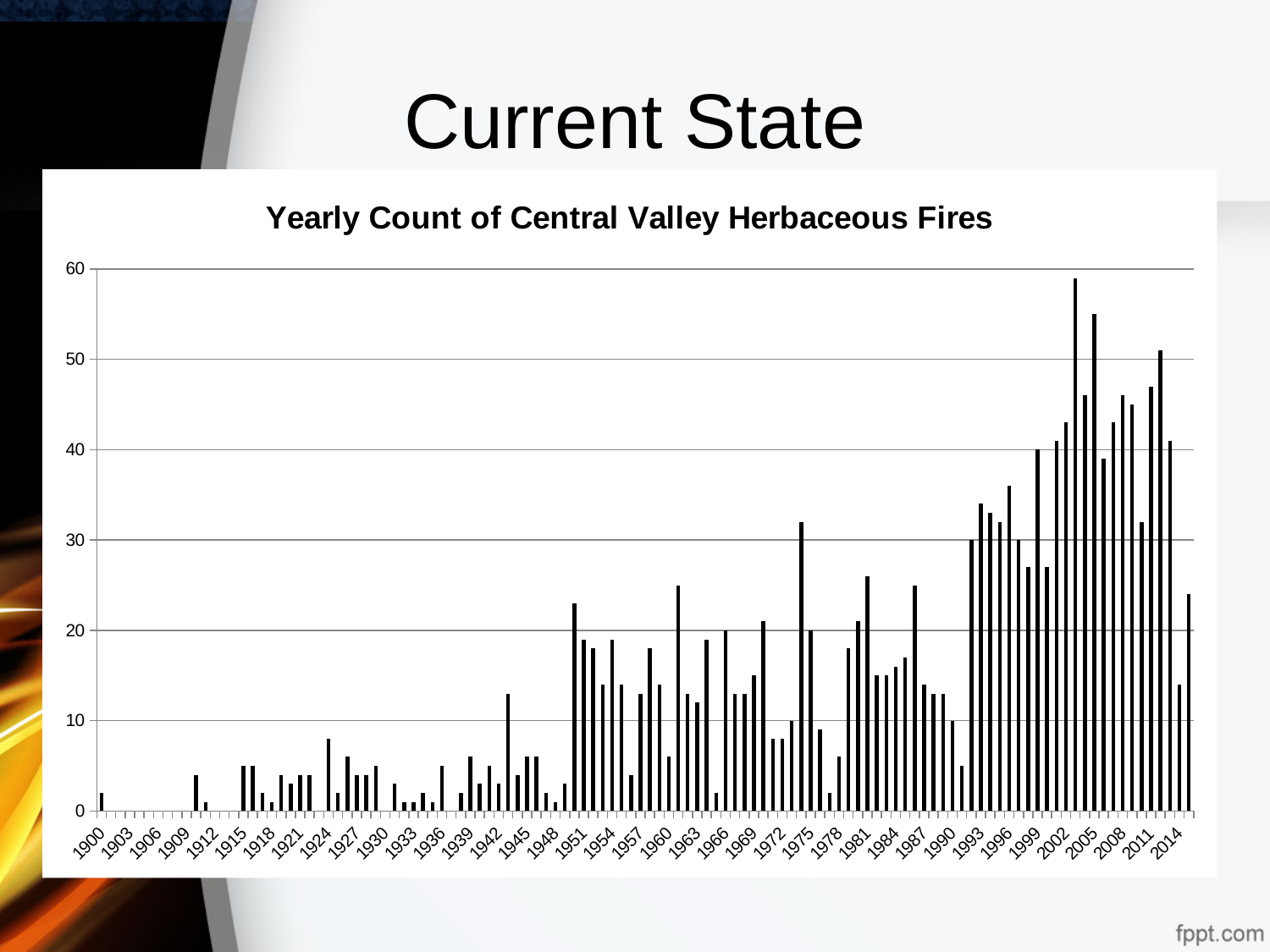
Is the value for 1951 greater or less than 10? greater Is the value for 1900 greater or less than 10? less Which year has the larger value, 1990 or 2002? 2002 What kind of chart is shown on the slide? bar chart Which year has the larger value, 1900 or 1975? 1975 Is the value for 1930 greater or less than 10? less What is the title of the chart? Yearly Count of Central Valley Herbaceous Fires What is the highest value shown on the vertical axis of the chart? 60 Overall, do the yearly fire counts rise or fall from 1900 to 2014? rise